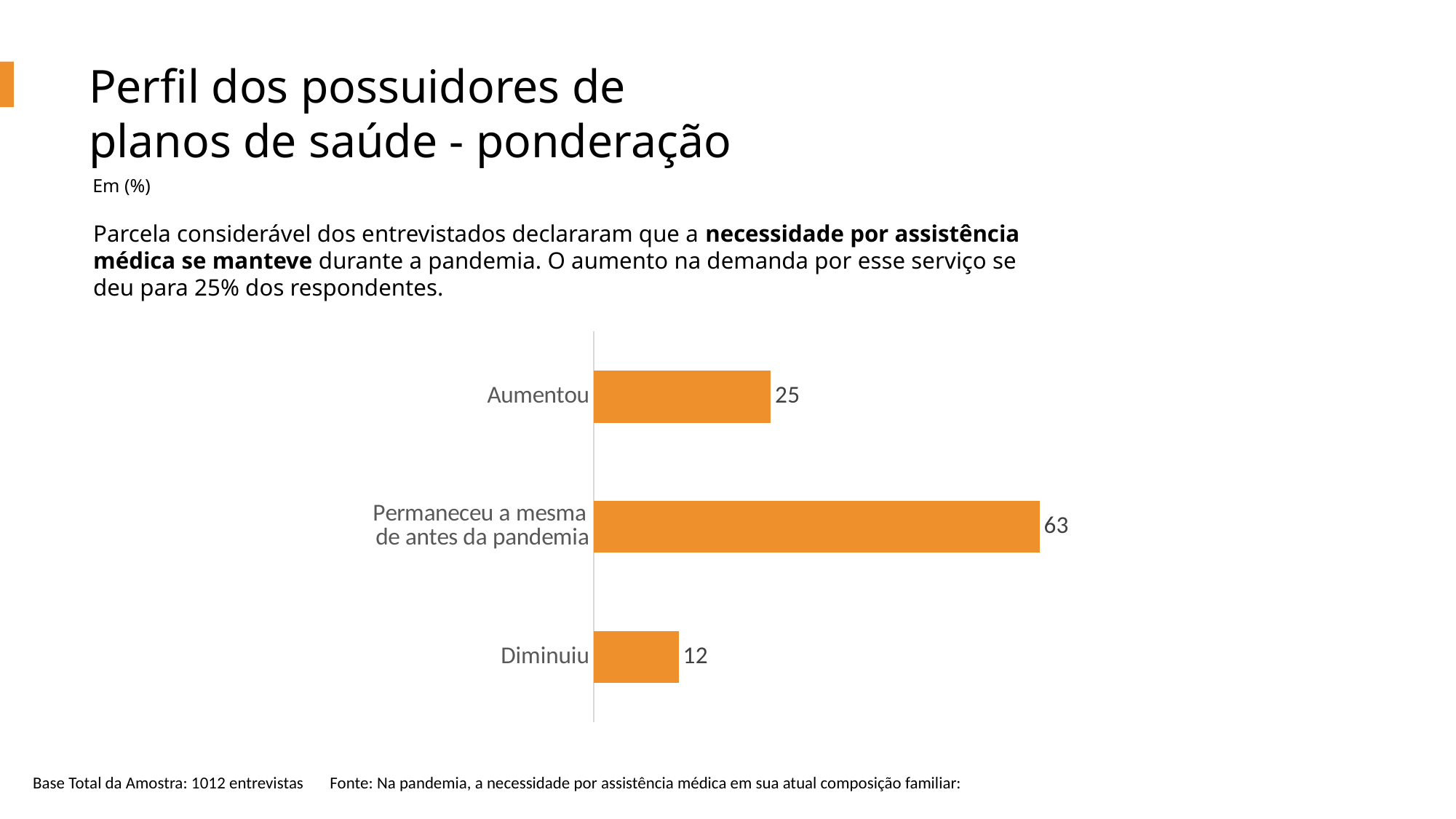
What is the total of the three values shown in the chart? 100 Which is larger, the value for "Aumentou" or the value for "Diminuiu"? Aumentou What is the value for "Diminuiu"? 12 How many categories are shown in the chart? 3 Which category has the lowest value? Diminuiu What is the difference between the values for "Aumentou" and "Diminuiu"? 13 What is the value for "Permaneceu a mesma de antes da pandemia"? 63 What kind of chart is shown on the slide? Bar chart What is the difference between the values for "Permaneceu a mesma de antes da pandemia" and "Aumentou"? 38 Which category has the highest value? Permaneceu a mesma de antes da pandemia What colour are the bars in the chart? Orange What is the value for "Aumentou"? 25